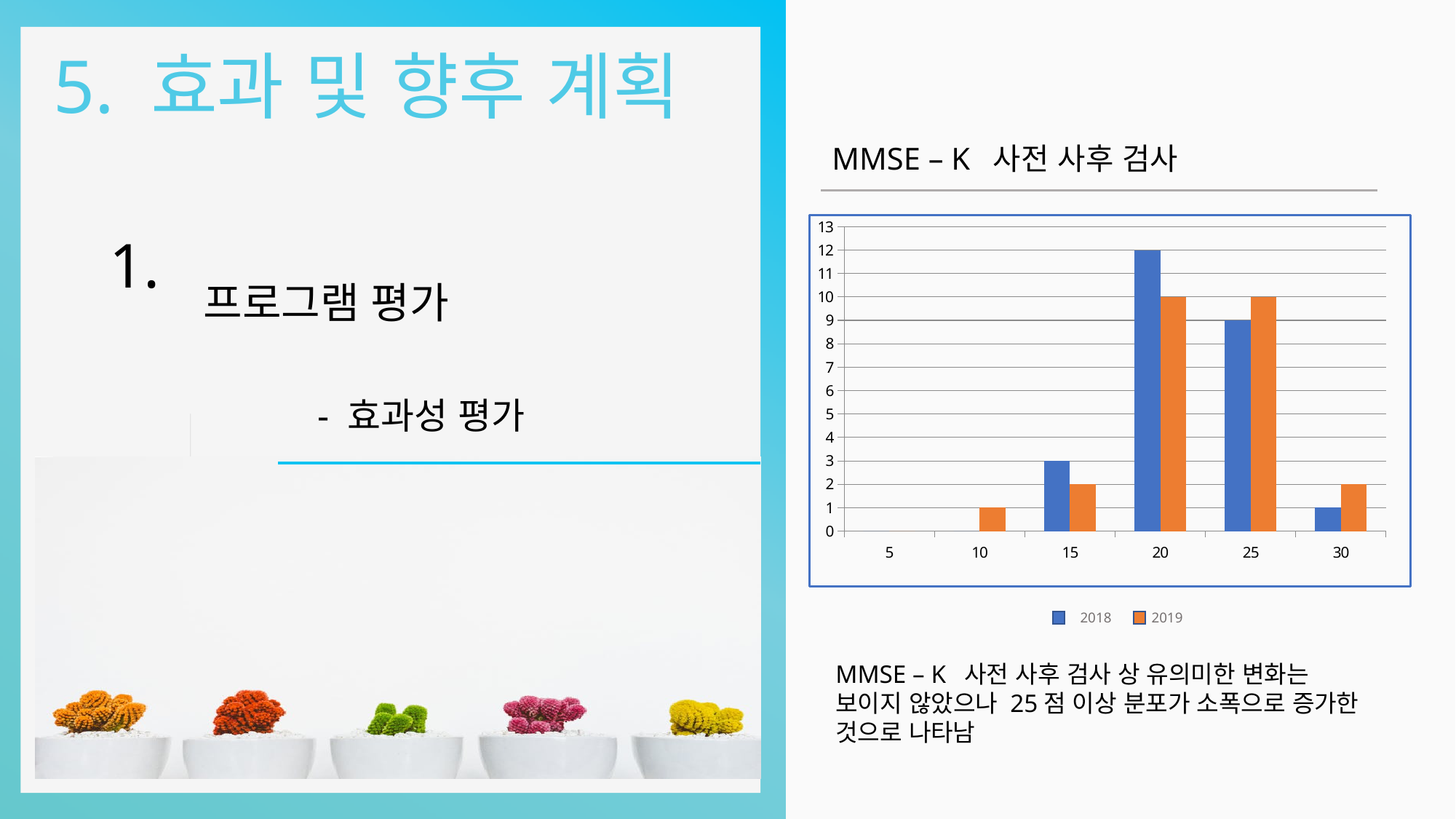
What is the value for 2018 at category 15? 3 What is the value for 2019 at category 10? 1 How many series does the chart legend list? 2 Which category has the highest value for the 2018 series? 20 What type of chart is shown on the slide? bar chart What is the title of the chart? MMSE – K 사전 사후 검사 How many categories are shown on the x axis of the chart? 6 At category 30, which series has the larger value, 2018 or 2019? 2019 Is the value for 2018 at category 25 greater or less than 5? greater What is the value for 2018 at category 20? 12 What is the value for 2019 at category 25? 10 What is the difference between the 2018 and 2019 values at category 20? 2